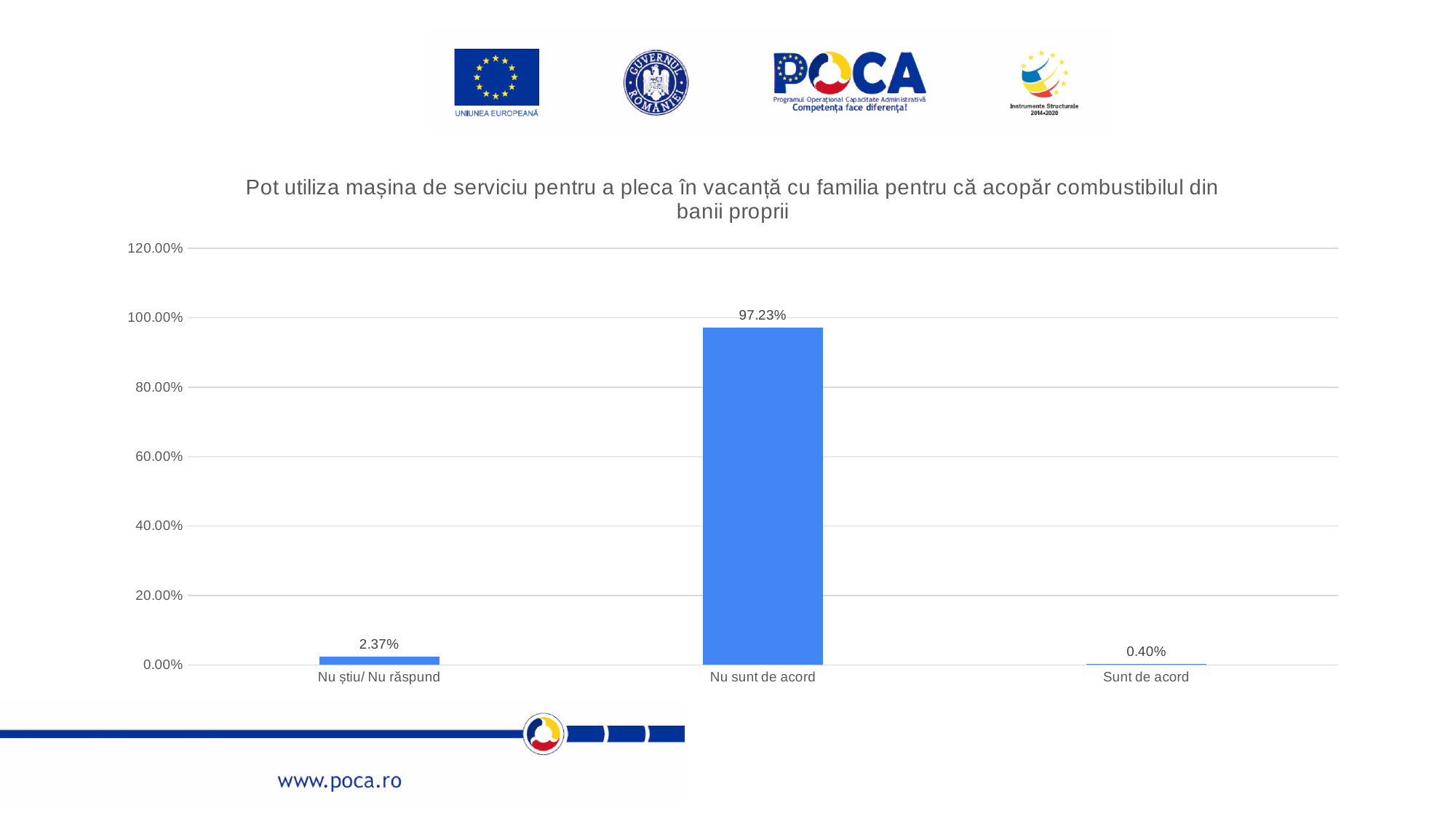
Which is larger, the value for "Nu știu/ Nu răspund" or the value for "Sunt de acord"? Nu știu/ Nu răspund What is the value for "Nu sunt de acord"? 97.23% Which category has the lowest value? Sunt de acord How many categories are shown on the x axis? 3 Which category has the highest value? Nu sunt de acord Is the value for "Nu sunt de acord" greater or less than 80.00%? greater What is the difference between the values for "Nu știu/ Nu răspund" and "Sunt de acord"? 1.97% What is the difference between the values for "Nu sunt de acord" and "Nu știu/ Nu răspund"? 94.86% What kind of chart is shown on the slide? bar chart What is the highest value shown on the y axis? 120.00% What is the value for "Nu știu/ Nu răspund"? 2.37% What is the value for "Sunt de acord"? 0.40%